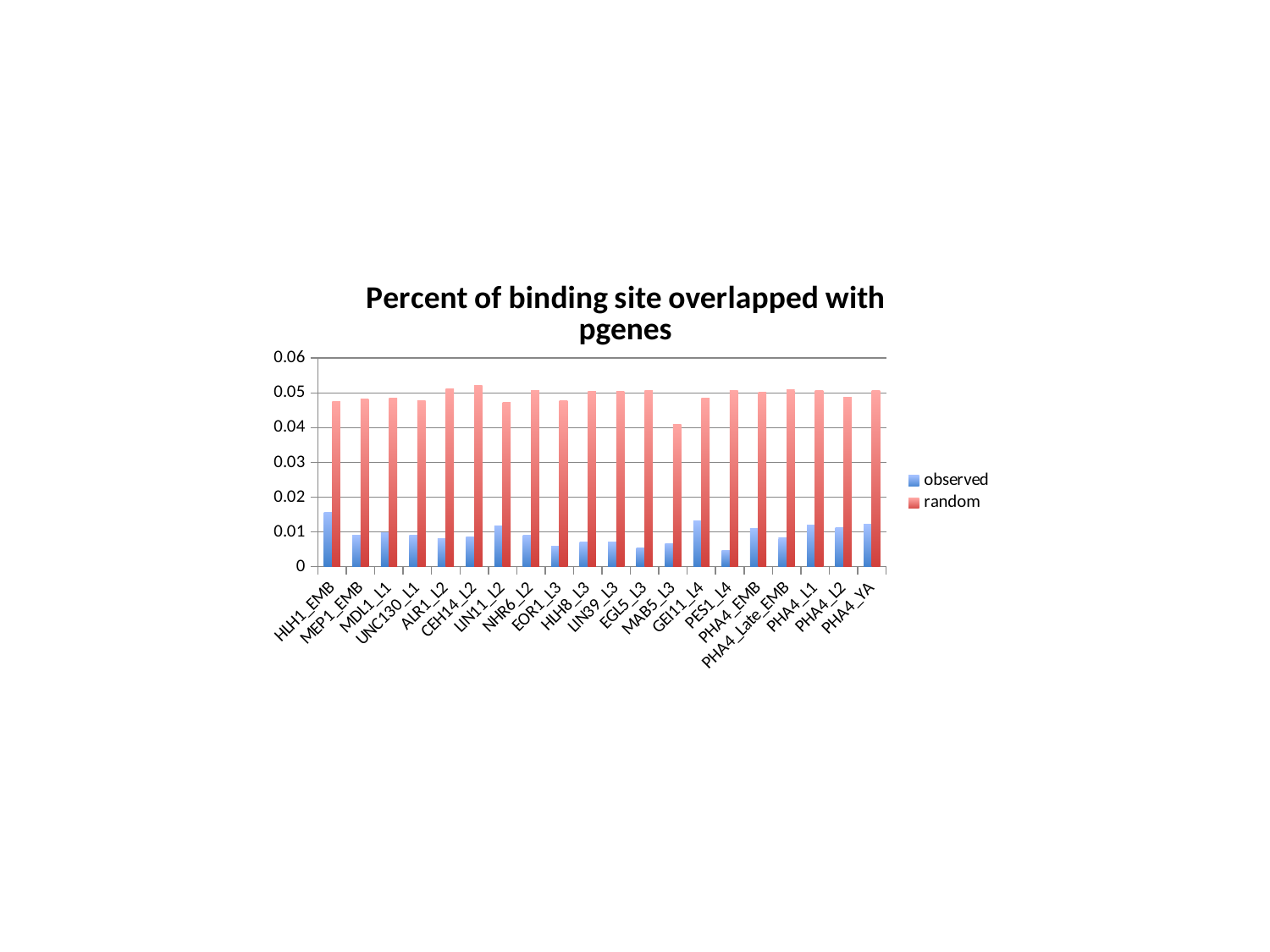
What kind of chart is shown on the slide? bar chart Is the random value for MAB5_L3 greater or less than 0.05? less Is the random value for CEH14_L2 greater or less than 0.05? greater Is the observed value for PES1_L4 greater or less than 0.01? less Which category has the lowest random value? MAB5_L3 For MDL1_L1, which is larger: the observed value or the random value? random Which category has the highest observed value? HLH1_EMB What is the title of the chart? Percent of binding site overlapped with pgenes How many series does the legend list? 2 How many categories are shown on the x axis? 20 Which is larger: the observed value for HLH1_EMB or the observed value for MAB5_L3? HLH1_EMB